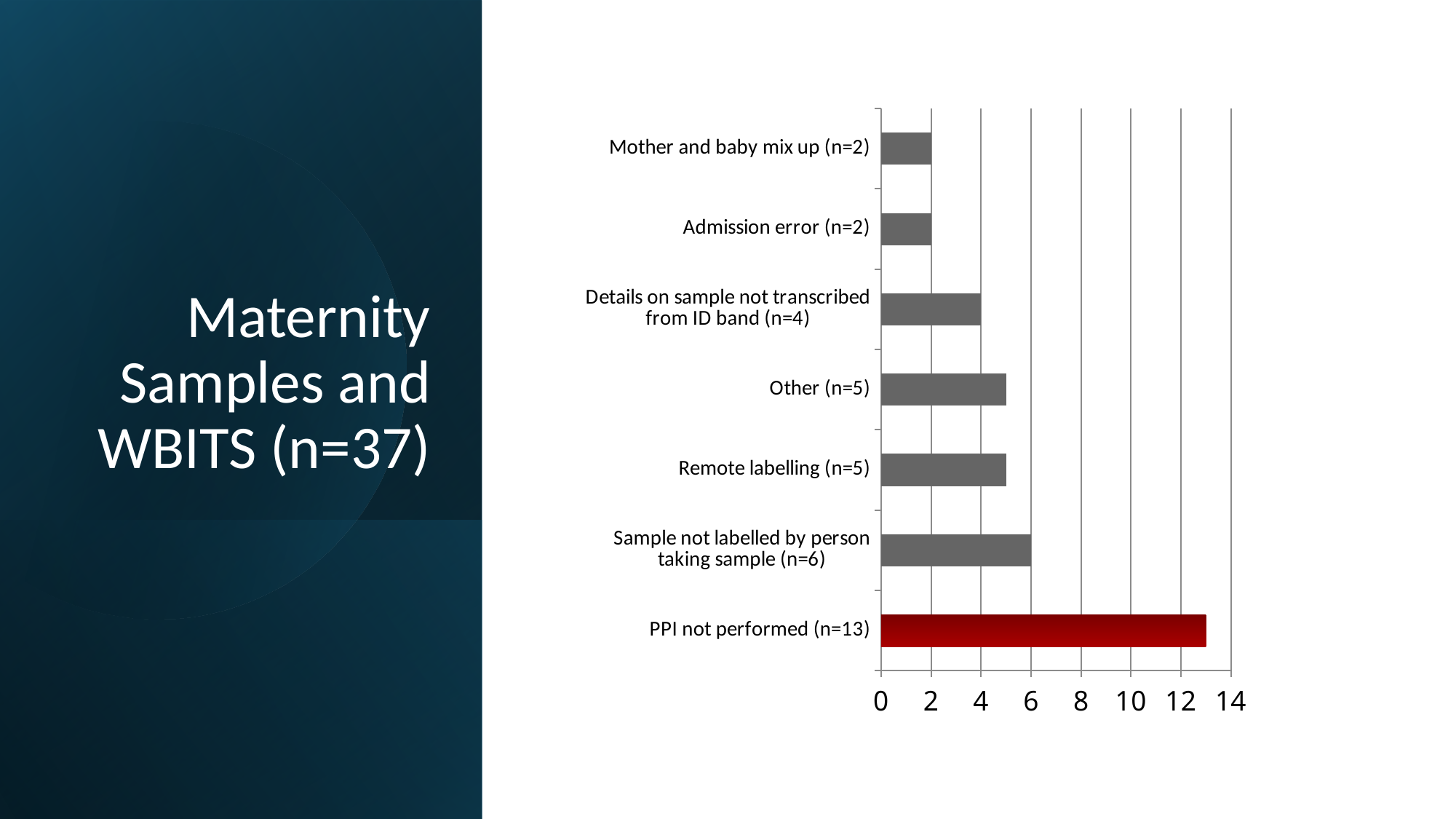
What is the difference between the values for Remote labelling and Mother and baby mix up? 3 Which bar is coloured dark red rather than grey? PPI not performed (n=13) What is the value for Sample not labelled by person taking sample? 6 Which category has the highest value? PPI not performed (n=13) What is the value for Details on sample not transcribed from ID band? 4 Which is larger, the value for Other or the value for Admission error? Other How many categories does the chart show? 7 What is the highest value shown on the x axis? 14 What is the value for PPI not performed? 13 What kind of chart is shown on the slide? bar chart Is the value for PPI not performed greater or less than 12? greater What is the difference between the values for PPI not performed and Sample not labelled by person taking sample? 7